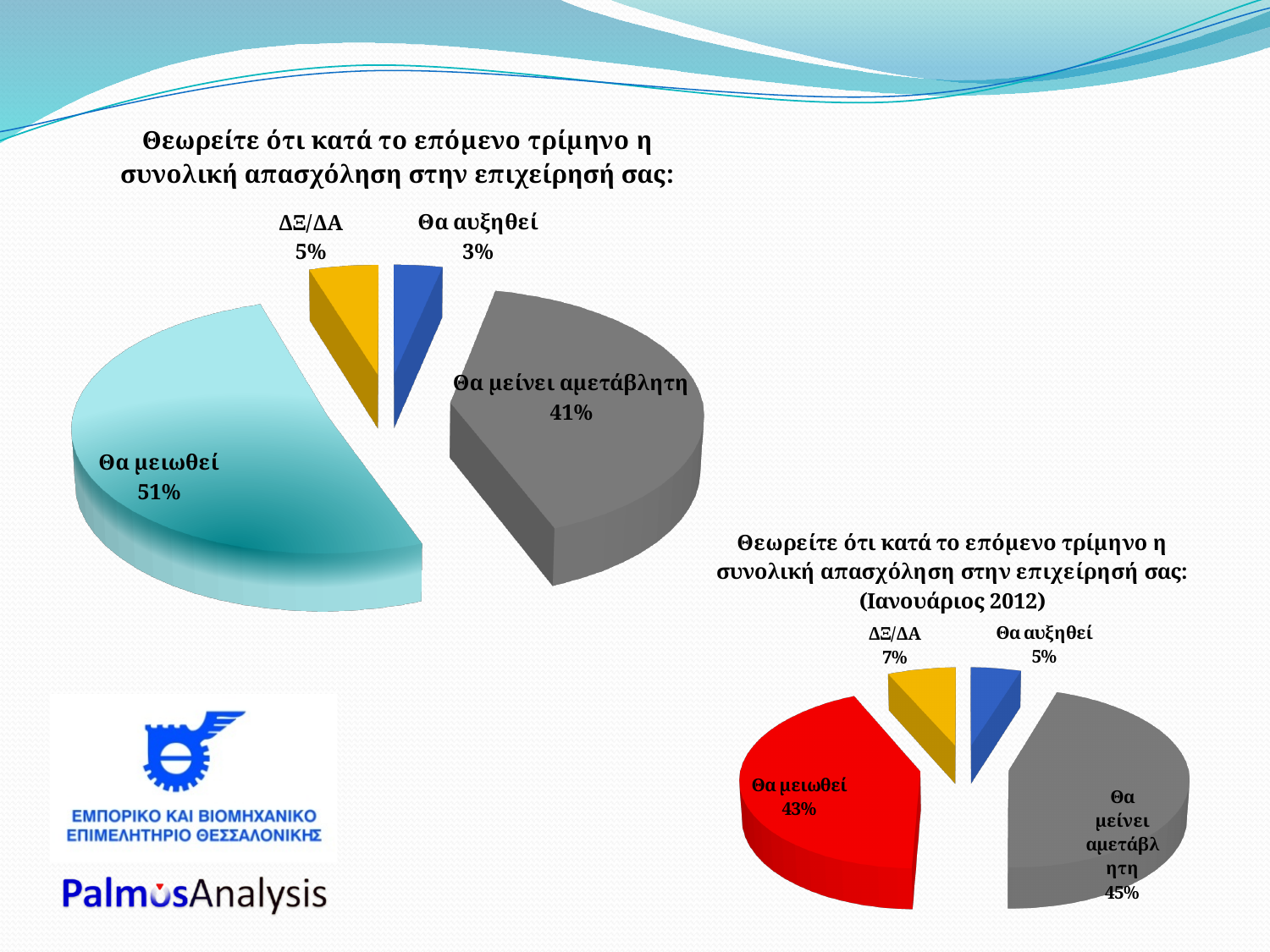
In the larger pie chart at the top left of the slide, which category has the smallest share? Θα αυξηθεί In the larger pie chart at the top left of the slide, what is the difference between the shares for "Θα μειωθεί" and "Θα μείνει αμετάβλητη"? 10% In the larger pie chart at the top left of the slide, which category has the largest share? Θα μειωθεί In the larger pie chart at the top left of the slide, what percentage is shown for "Θα μείνει αμετάβλητη"? 41% Which is larger: the share for "Θα αυξηθεί" in the top-left pie chart or in the Ιανουάριος 2012 pie chart at the bottom right? The Ιανουάριος 2012 pie chart (5%) In the pie chart for Ιανουάριος 2012 at the bottom right, what percentage is shown for "ΔΞ/ΔΑ"? 7% How many slices does the larger pie chart at the top left of the slide have? 4 What type of chart is the chart titled "(Ιανουάριος 2012)" at the bottom right of the slide? Pie chart In the larger pie chart at the top left of the slide, what percentage is shown for "Θα μειωθεί"? 51% In the pie chart for Ιανουάριος 2012 at the bottom right, which category has the largest share? Θα μείνει αμετάβλητη In the larger pie chart at the top left of the slide, what colour is the "Θα μειωθεί" slice? Light blue (cyan) In the pie chart for Ιανουάριος 2012 at the bottom right, what percentage is shown for "Θα μειωθεί"? 43%